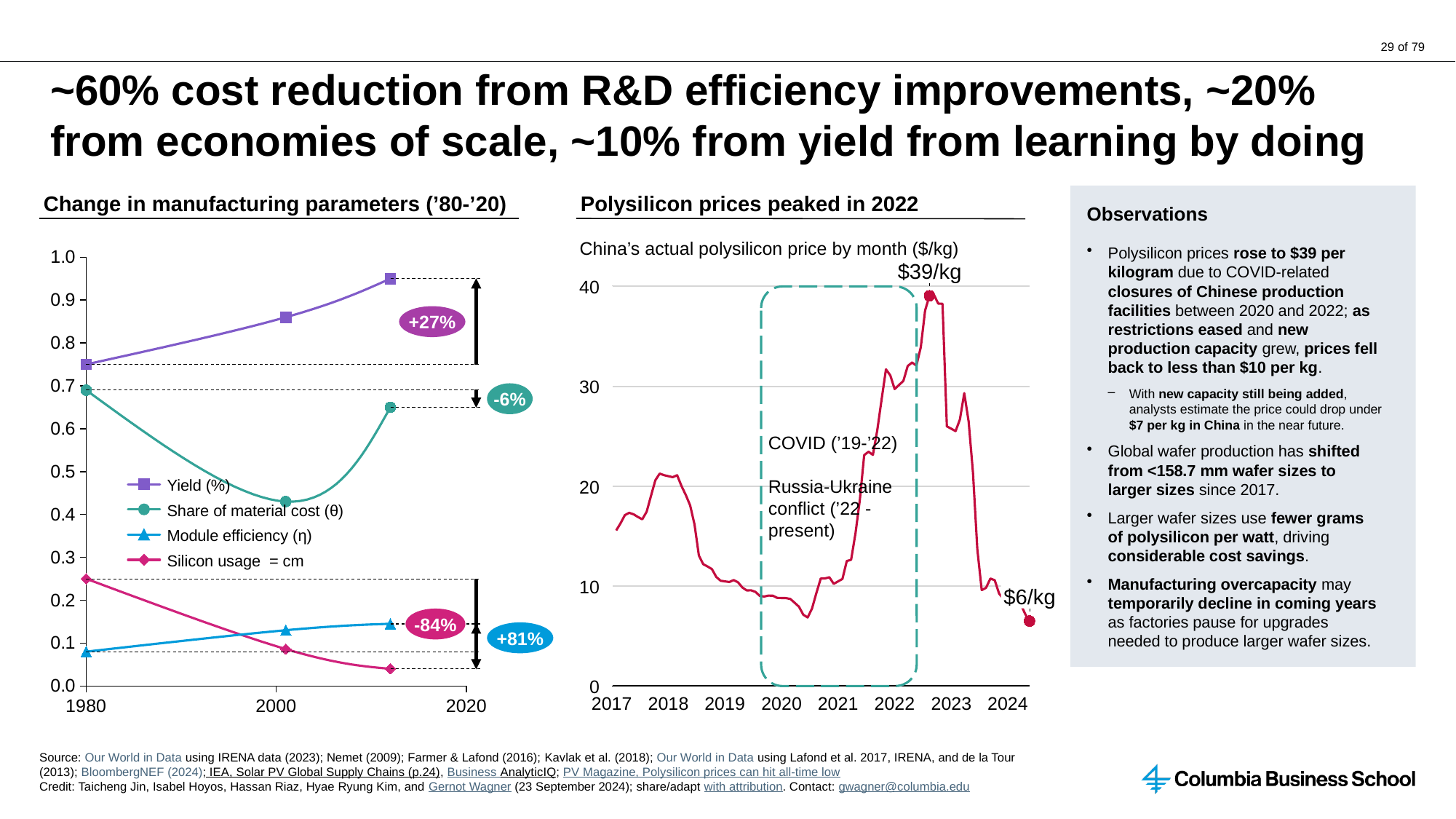
In the 'Change in manufacturing parameters ('80-'20)' chart, what percentage change is labelled for Silicon usage? -84% In the 'Polysilicon prices peaked in 2022' chart, what is the labelled peak price? $39/kg In the 'Change in manufacturing parameters ('80-'20)' chart, what percentage change is labelled for Yield (%)? +27% In the 'Change in manufacturing parameters ('80-'20)' chart, does Silicon usage rise or fall from 1980 to 2020? Fall What kind of chart is the 'Change in manufacturing parameters ('80-'20)' chart? Line chart In the 'Polysilicon prices peaked in 2022' chart, is the price in 2018 greater or less than 30? less In the 'Change in manufacturing parameters ('80-'20)' chart, what percentage change is labelled for Module efficiency (η)? +81% In the 'Polysilicon prices peaked in 2022' chart, what is the labelled price at the end of the series in 2024? $6/kg In the 'Change in manufacturing parameters ('80-'20)' chart, is the Yield (%) value in 2020 greater or less than 0.9? greater In the 'Polysilicon prices peaked in 2022' chart, what period does the dashed box mark? COVID ('19-'22) How many series does the legend of the 'Change in manufacturing parameters ('80-'20)' chart list? 4 In the 'Change in manufacturing parameters ('80-'20)' chart, what percentage change is labelled for Share of material cost (θ)? -6%